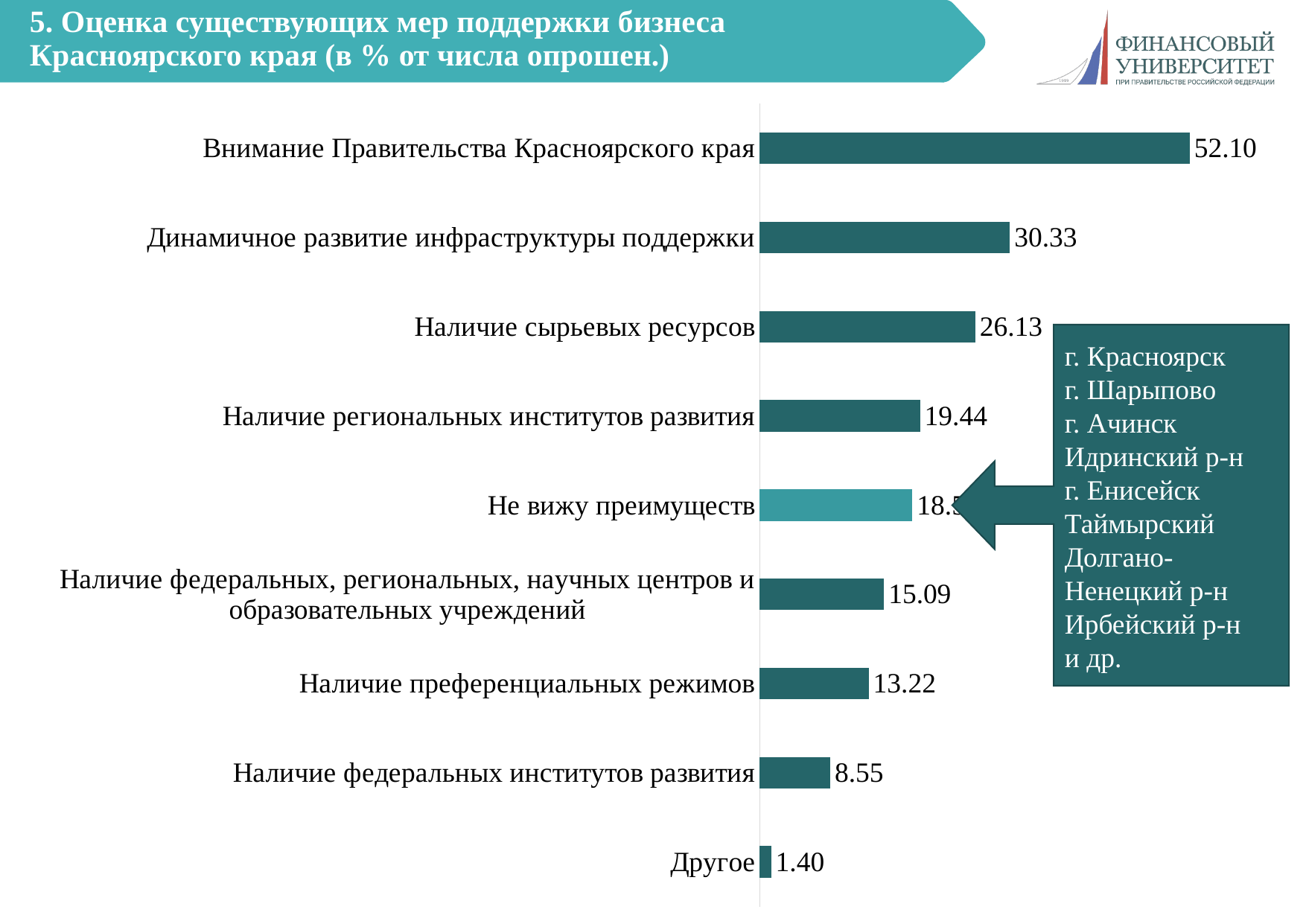
What is the difference between the values for "Внимание Правительства Красноярского края" and "Динамичное развитие инфраструктуры поддержки"? 21.77 How many categories are shown in the chart? 9 What value is shown for "Динамичное развитие инфраструктуры поддержки"? 30.33 Which category has the lowest value? Другое What value is shown for "Внимание Правительства Красноярского края"? 52.10 What value is shown for "Наличие сырьевых ресурсов"? 26.13 Which category has the highest value? Внимание Правительства Красноярского края Which bar is drawn in a lighter colour than the others? Не вижу преимуществ What kind of chart is shown on the slide? Bar chart What value is shown for "Наличие федеральных институтов развития"? 8.55 Which is larger: the value for "Наличие региональных институтов развития" or for "Наличие федеральных, региональных, научных центров и образовательных учреждений"? Наличие региональных институтов развития What is the difference between the values for "Наличие преференциальных режимов" and "Наличие федеральных институтов развития"? 4.67